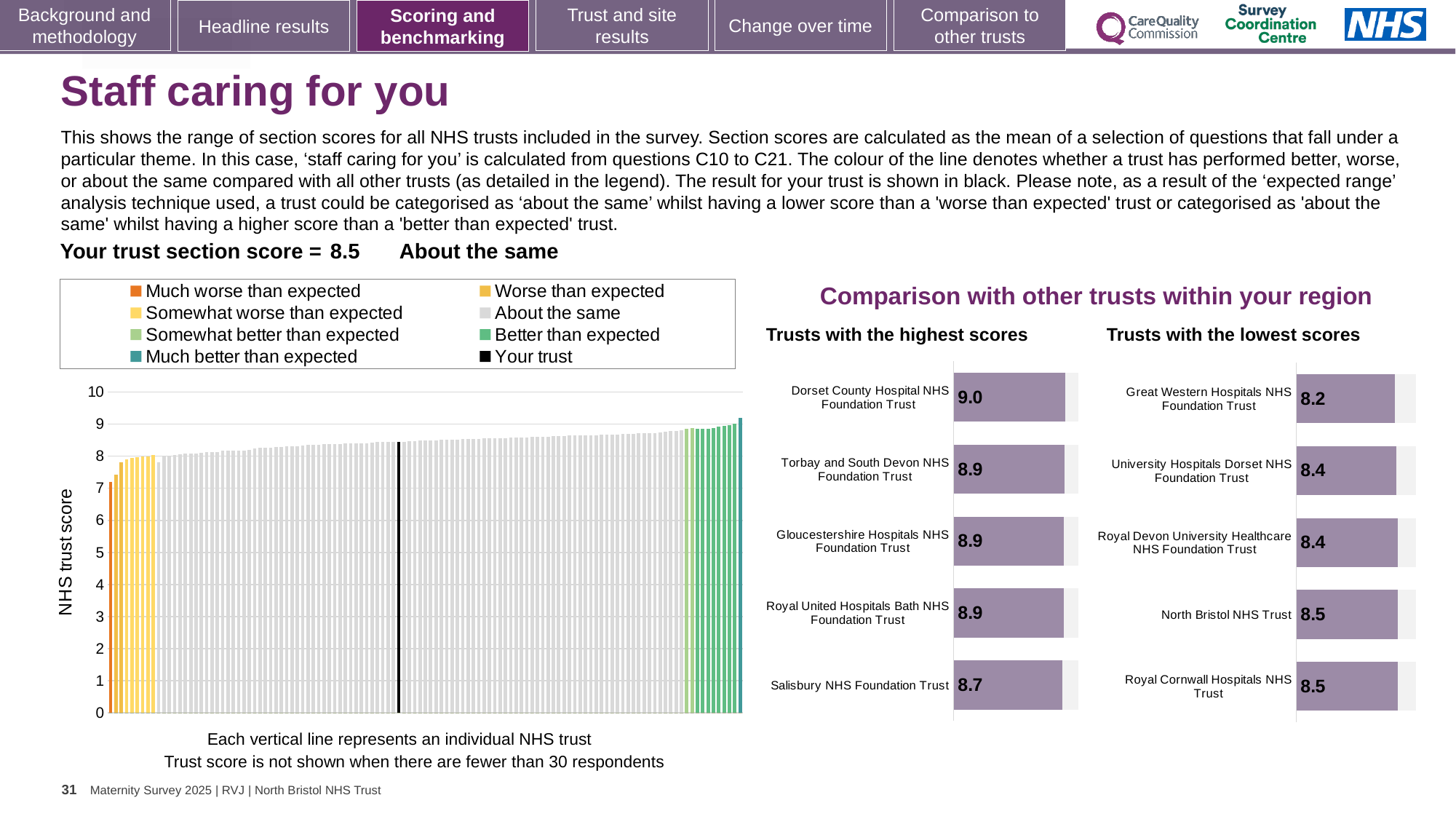
In the 'Trusts with the highest scores' chart, what is the score for Salisbury NHS Foundation Trust? 8.7 In the 'Trusts with the lowest scores' chart, which trust has the lowest score? Great Western Hospitals NHS Foundation Trust In the 'Trusts with the lowest scores' chart, what is the score for Great Western Hospitals NHS Foundation Trust? 8.2 How many entries does the legend of the main 'NHS trust score' chart list? 8 In the main 'NHS trust score' chart, do the trust scores rise or fall from left to right? Rise In the 'Trusts with the highest scores' chart, what is the difference between the scores of Dorset County Hospital NHS Foundation Trust and Salisbury NHS Foundation Trust? 0.3 In the 'Trusts with the highest scores' chart, which trust has the highest score? Dorset County Hospital NHS Foundation Trust How many trusts are shown in the 'Trusts with the highest scores' chart? 5 What kind of chart is the main 'NHS trust score' chart on the left of the slide? Bar chart In the 'Trusts with the highest scores' chart, what is the score for Dorset County Hospital NHS Foundation Trust? 9.0 In the 'Trusts with the lowest scores' chart, what is the score for Royal Cornwall Hospitals NHS Trust? 8.5 In the 'Trusts with the lowest scores' chart, which has the larger score: North Bristol NHS Trust or Great Western Hospitals NHS Foundation Trust? North Bristol NHS Trust